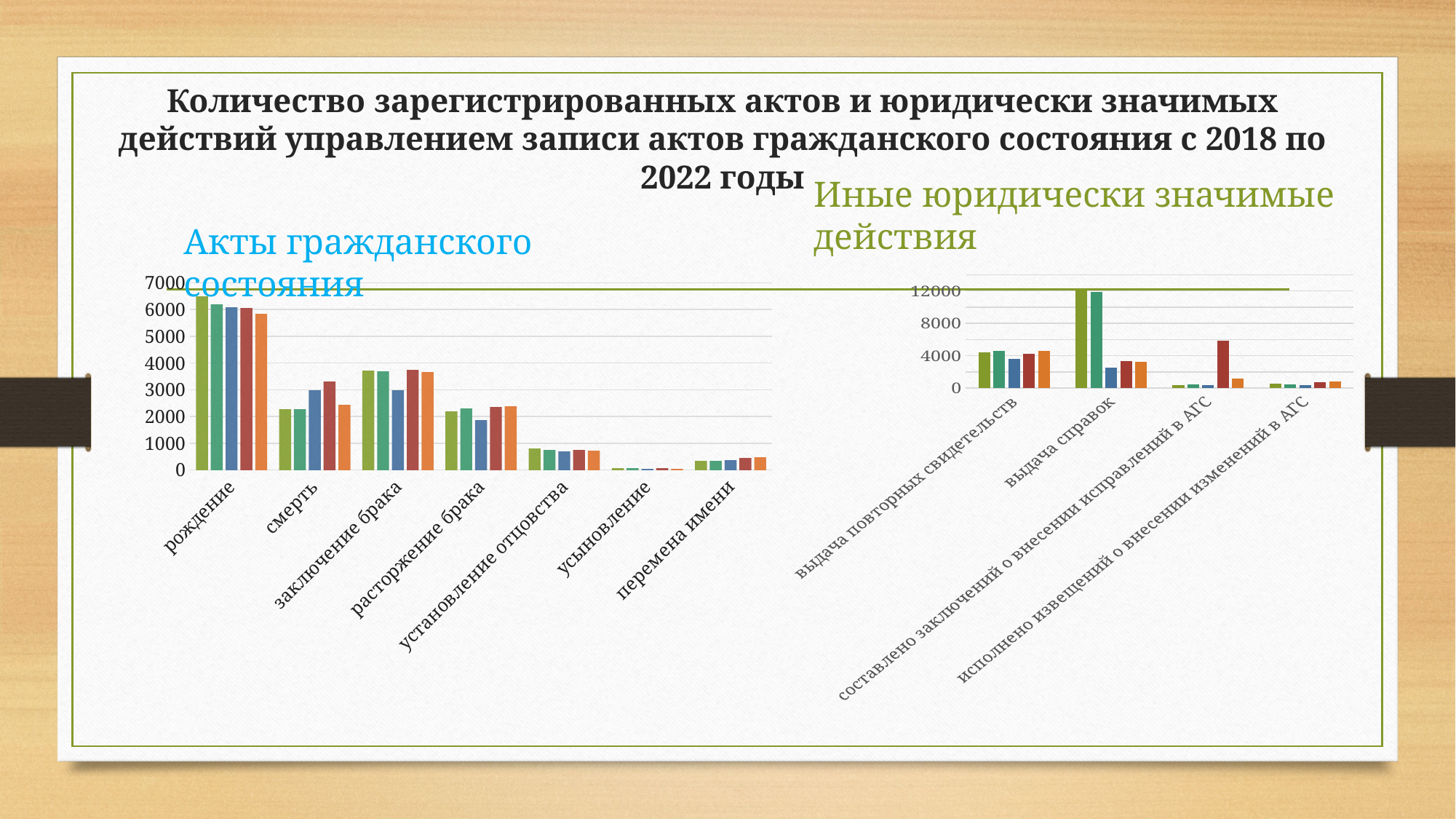
In the left chart "Акты гражданского состояния", how many categories are shown on the x axis? 7 In the left chart "Акты гражданского состояния", which category has higher bars: рождение or смерть? рождение In the left chart "Акты гражданского состояния", is the value of the first bar for рождение greater or less than 6000? greater In the left chart "Акты гражданского состояния", which category has the lowest bars? усыновление What kind of chart is the right chart titled "Иные юридически значимые действия"? bar chart In the left chart "Акты гражданского состояния", which category has the tallest bars? рождение In the left chart "Акты гражданского состояния", are the bars for перемена имени greater or less than 1000? less In the right chart "Иные юридически значимые действия", which category contains the tallest bar? выдача справок In the right chart "Иные юридически значимые действия", how many categories are shown on the x axis? 4 What kind of chart is the left chart titled "Акты гражданского состояния"? bar chart In the right chart "Иные юридически значимые действия", is the first bar for выдача справок greater or less than 8000? greater In the left chart "Акты гражданского состояния", do the bars for рождение rise or fall from left to right? fall